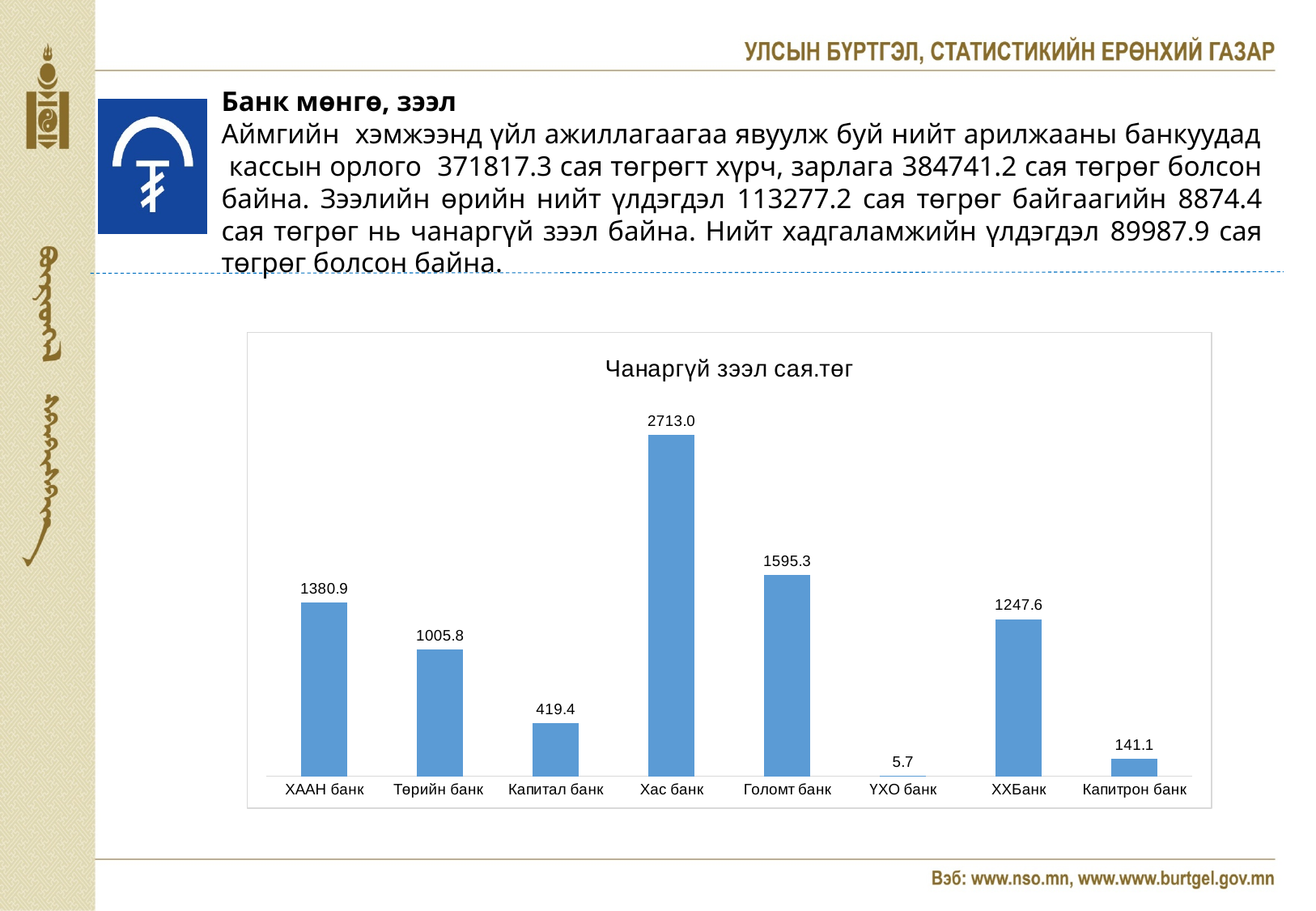
What is the value for Капитрон банк? 141.1 Which is larger, the value for Голомт банк or the value for ХХБанк? Голомт банк What is the difference between the values for Хас банк and Голомт банк? 1117.7 What is the value for ҮХО банк? 5.7 What is the difference between the values for ХААН банк and Төрийн банк? 375.1 Which bank has the highest value? Хас банк How many banks are shown on the chart? 8 What kind of chart is shown on the slide? bar chart What is the title of the chart? Чанаргүй зээл сая.төг Which bank has the lowest value? ҮХО банк What is the value for Хас банк? 2713.0 What is the value for ХААН банк? 1380.9